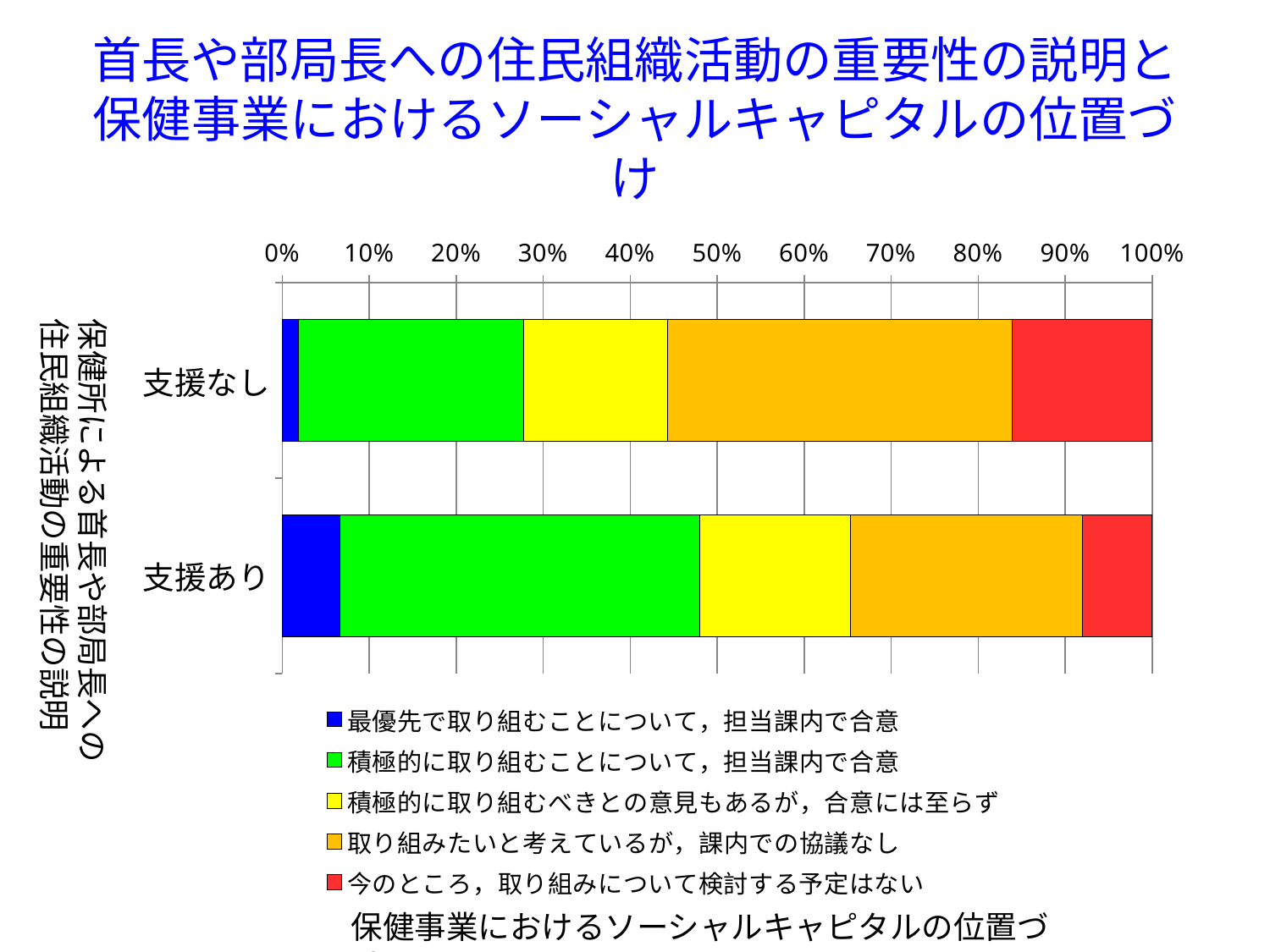
Is the value for 取り組みたいと考えているが，課内での協議なし in the 支援なし bar greater or less than 30%? greater How many categories (bars) does the chart show? 2 What kind of chart is shown on the slide? stacked bar chart Is the value for 今のところ，取り組みについて検討する予定はない in the 支援あり bar greater or less than 10%? less Which segment is the largest in the 支援あり bar? 積極的に取り組むことについて，担当課内で合意 Which segment is the largest in the 支援なし bar? 取り組みたいと考えているが，課内での協議なし How many series does the legend list? 5 Is the share of 今のところ，取り組みについて検討する予定はない larger for 支援あり or 支援なし? 支援なし Is the share of 積極的に取り組むことについて，担当課内で合意 larger for 支援あり or 支援なし? 支援あり Is the value for 積極的に取り組むことについて，担当課内で合意 in the 支援あり bar greater or less than 30%? greater What colour represents 最優先で取り組むことについて，担当課内で合意 in the legend? blue Which segment is the smallest in the 支援なし bar? 最優先で取り組むことについて，担当課内で合意